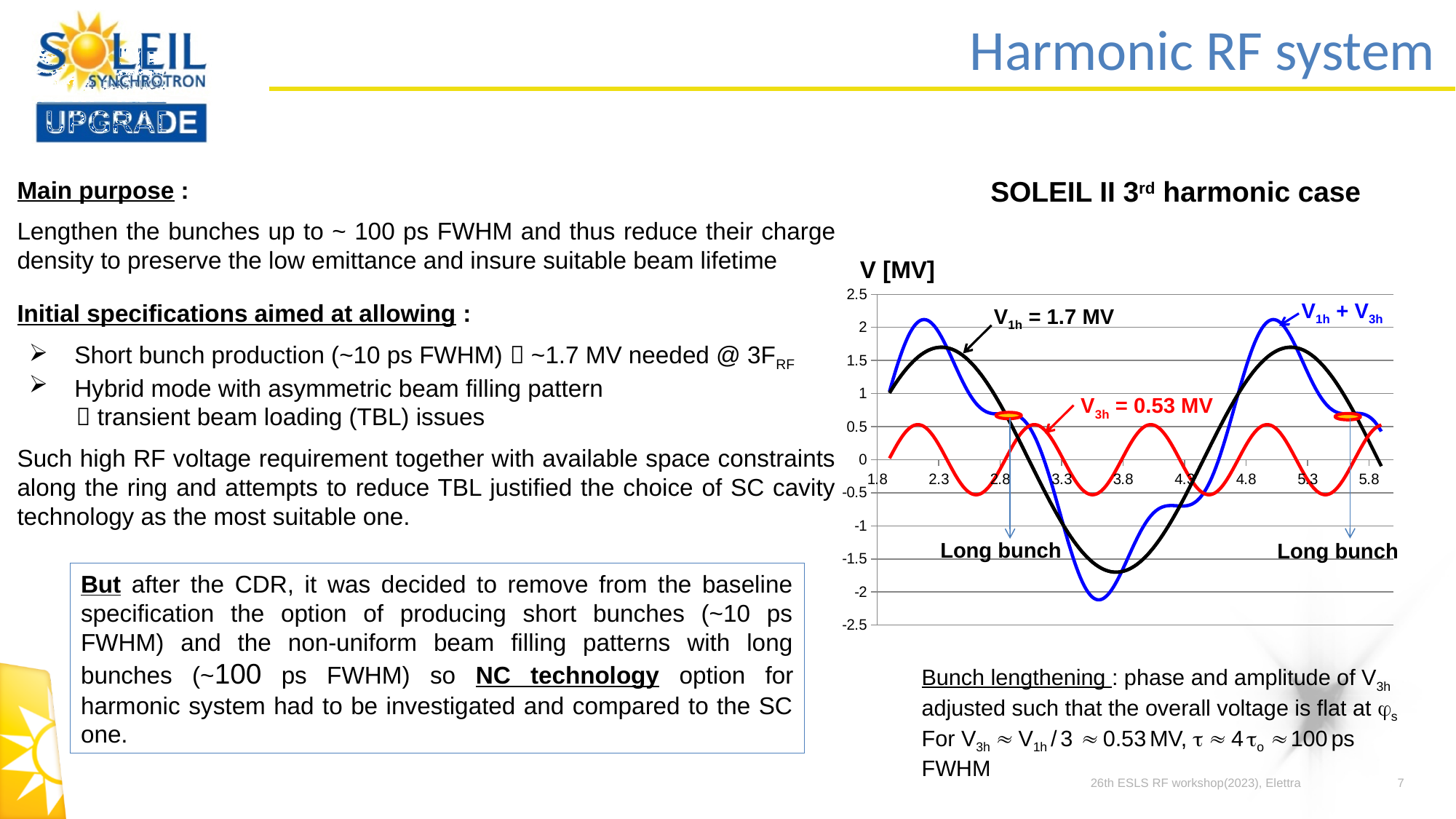
Is the peak value of the black V1h curve greater or less than 2? less Is the peak value of the red V3h curve greater or less than 1? less What is the amplitude of V1h as labelled on the chart? 1.7 MV How many curves are plotted on the chart? 3 What is the label of the y axis? V [MV] Which curve has the larger amplitude, V1h or V3h? V1h What is the difference between the labelled amplitudes of V1h and V3h? 1.17 MV How many tick labels are shown on the x axis? 9 What is the title above the chart? SOLEIL II 3rd harmonic case What is the amplitude of V3h as labelled on the chart? 0.53 MV What kind of chart is shown on the slide? line chart What is the maximum value shown on the y axis? 2.5